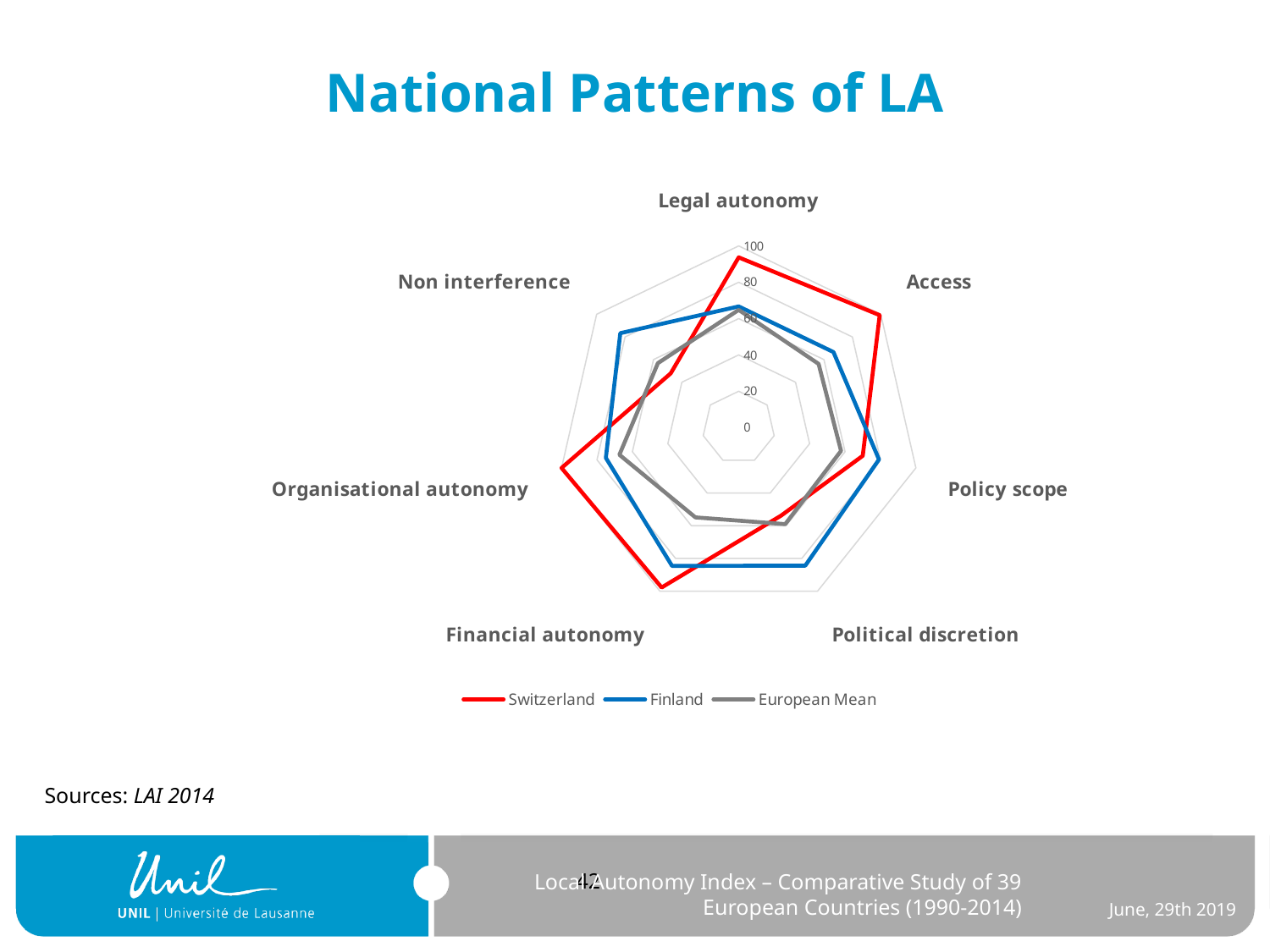
Which colour represents Switzerland in the chart? Red Is the value for Finland on Non interference greater or less than 60? greater On Non interference, which has the higher value: Finland or Switzerland? Finland Is the value for the European Mean on Political discretion greater or less than 80? less Is the value for Switzerland on Legal autonomy greater or less than 80? greater How many series does the legend list? 3 On Political discretion, which has the higher value: Finland or the European Mean? Finland How many dimensions (axes) are plotted on the radar chart? 7 What kind of chart is shown on the slide? Radar chart On Access, which has the higher value: Switzerland or Finland? Switzerland On which dimension does Switzerland have its lowest value? Non interference